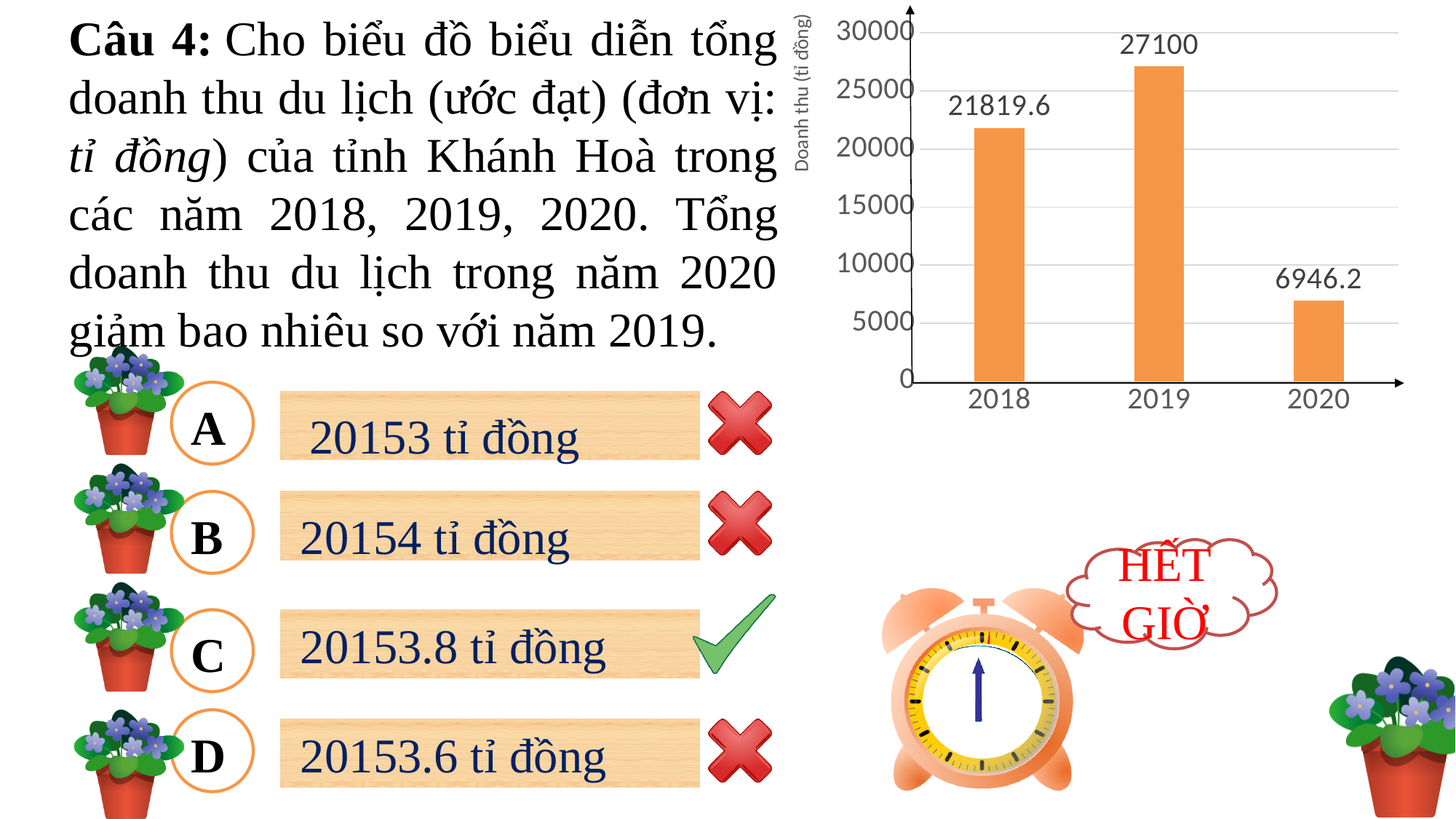
What kind of chart is shown on the slide? bar chart How many years are shown on the x axis of the chart? 3 Which year has the highest value in the chart? 2019 What is the label of the vertical axis of the chart? Doanh thu (tỉ đồng) Which year has the lowest value in the chart? 2020 What is the difference between the values for 2019 and 2018? 5280.4 What is the difference between the values for 2019 and 2020? 20153.8 Which is larger, the value for 2018 or the value for 2020? 2018 What is the value for 2020 in the chart? 6946.2 Is the value for 2020 greater or less than 10000? less What is the value for 2018 in the chart? 21819.6 What is the value for 2019 in the chart? 27100